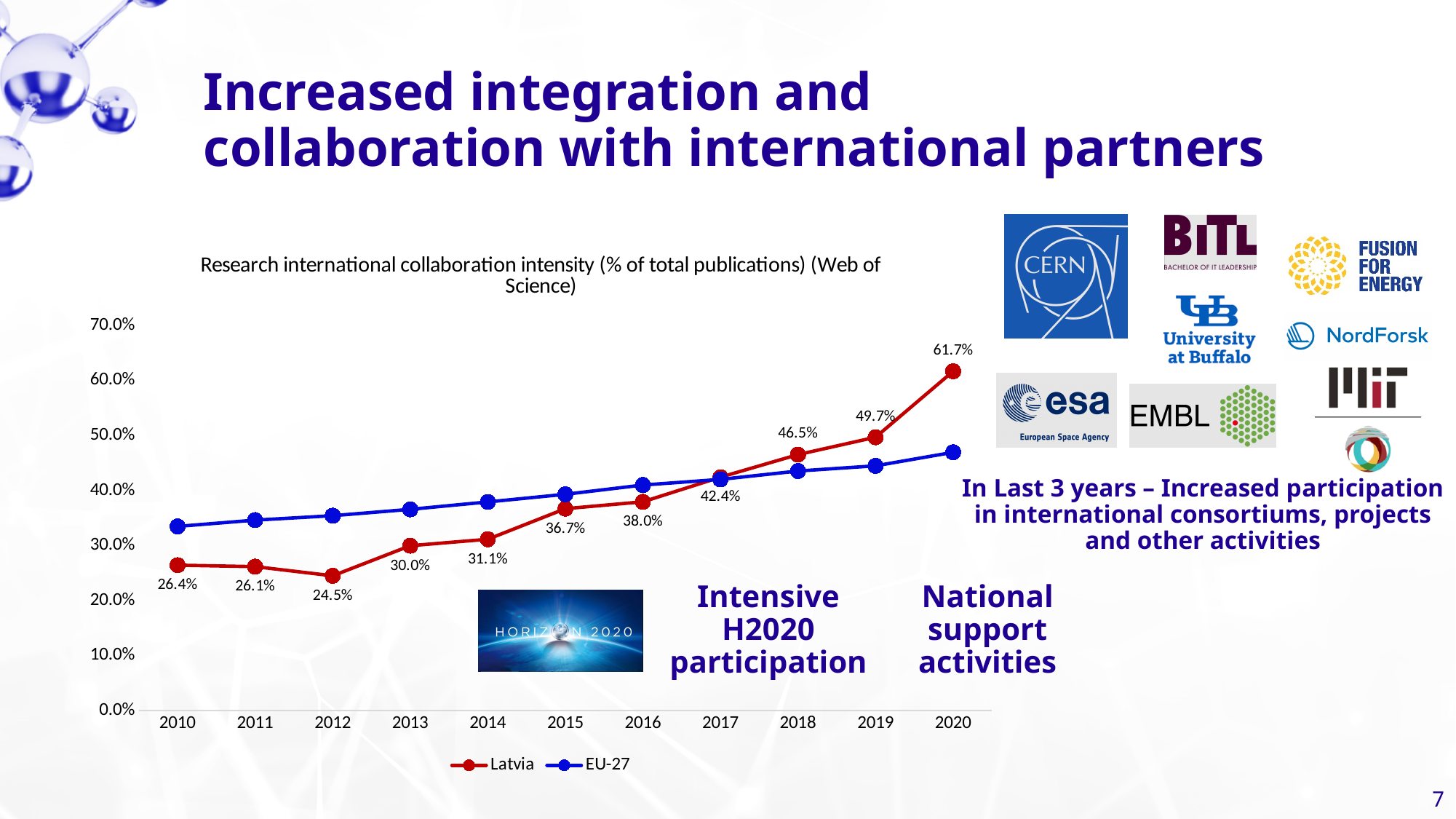
What kind of chart is shown on the slide? Line chart What is the value for Latvia in 2017? 42.4% In which year is the Latvia series at its lowest? 2012 How many series does the legend list? 2 Is the value for EU-27 in 2010 greater or less than 30.0%? greater What is the difference between the Latvia values for 2020 and 2019? 12.0% What is the value for Latvia in 2013? 30.0% In which year is the Latvia series at its highest? 2020 In 2020, which series has the higher value, Latvia or EU-27? Latvia In 2010, which series has the higher value, Latvia or EU-27? EU-27 How many years are shown on the x axis? 11 What is the value for Latvia in 2020? 61.7%